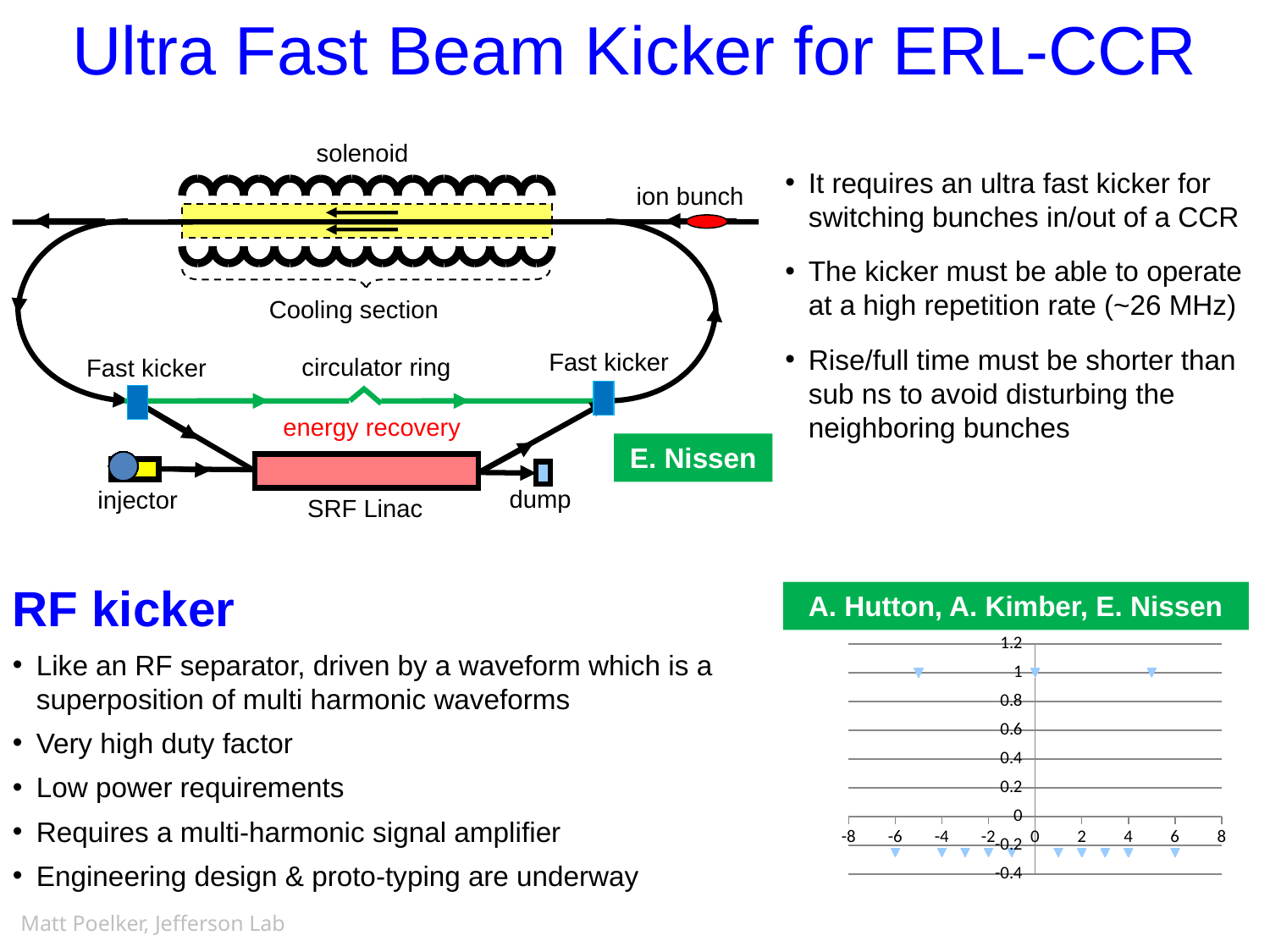
In the chart at the bottom right, is the value of the point at x = 0 greater or less than 0.5? greater What kind of chart is shown at the bottom right of the slide? scatter chart In the chart at the bottom right, how many points lie at the y value of 1? 3 In the chart at the bottom right, what is the highest tick label on the y axis? 1.2 In the chart at the bottom right, which point has the larger value: the one at x = 0 or the one at x = 2? x = 0 In the chart at the bottom right, is the value of the point at x = -6 greater or less than 0.5? less In the chart at the bottom right, what is the lowest tick label on the x axis? -8 In the chart at the bottom right, is the value of the point at x = 4 greater or less than 0.2? less In the chart at the bottom right, what is the y value of the point at x = 0? 1